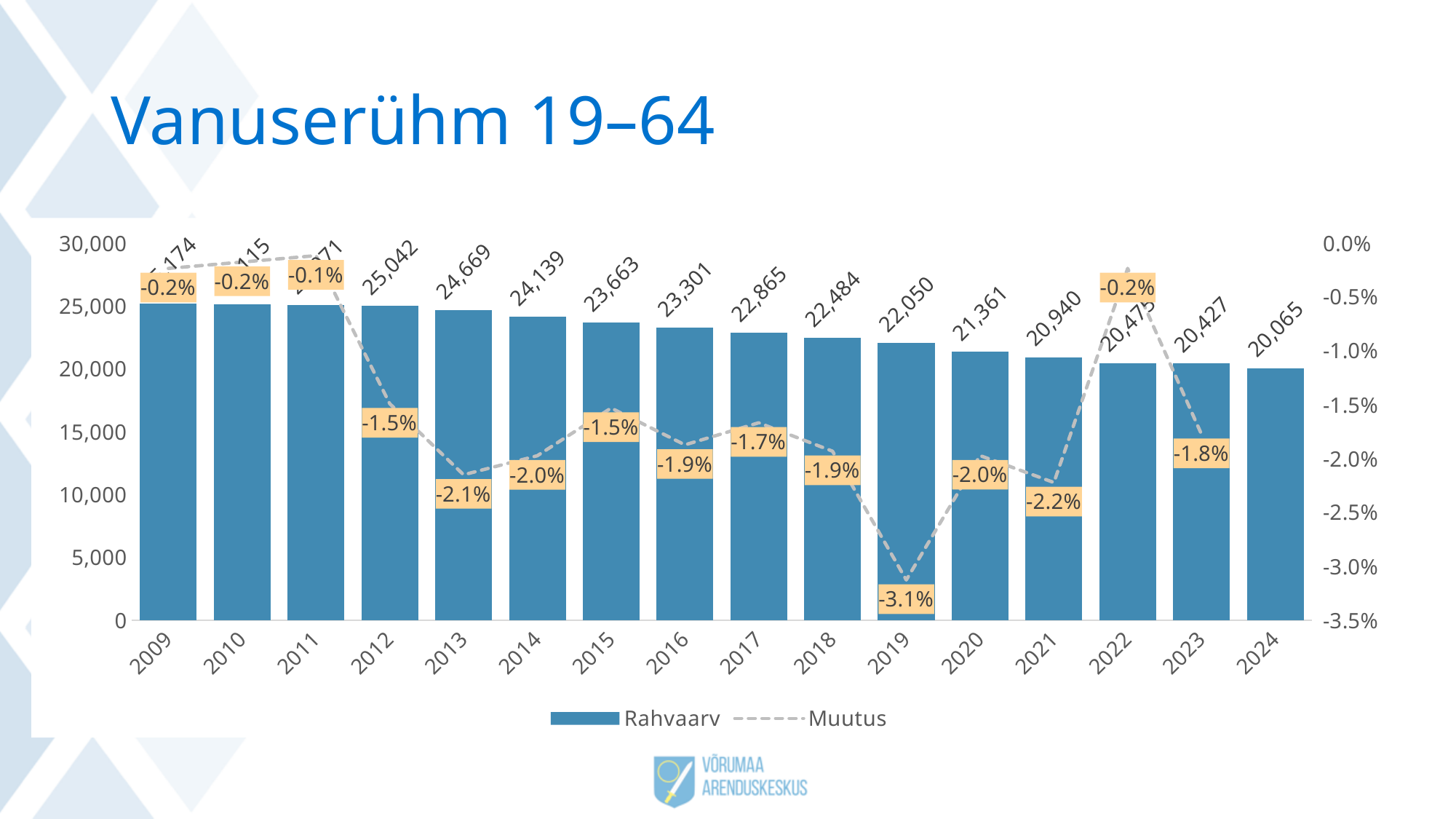
Which year has the lowest Muutus value? 2019 What is the Rahvaarv value for 2024? 20,065 Do the Rahvaarv bars rise or fall from 2009 to 2024? fall What is the Muutus value for 2013? -2.1% Which year has the lowest Rahvaarv value? 2024 What is the difference in Rahvaarv between 2012 and 2024? 4,977 What is the Rahvaarv value for 2019? 22,050 How many years are shown on the x axis? 16 How many series does the legend list? 2 What is the Muutus value for 2019? -3.1% What is the Rahvaarv value for 2012? 25,042 Which is larger, the Rahvaarv value for 2016 or for 2018? 2016